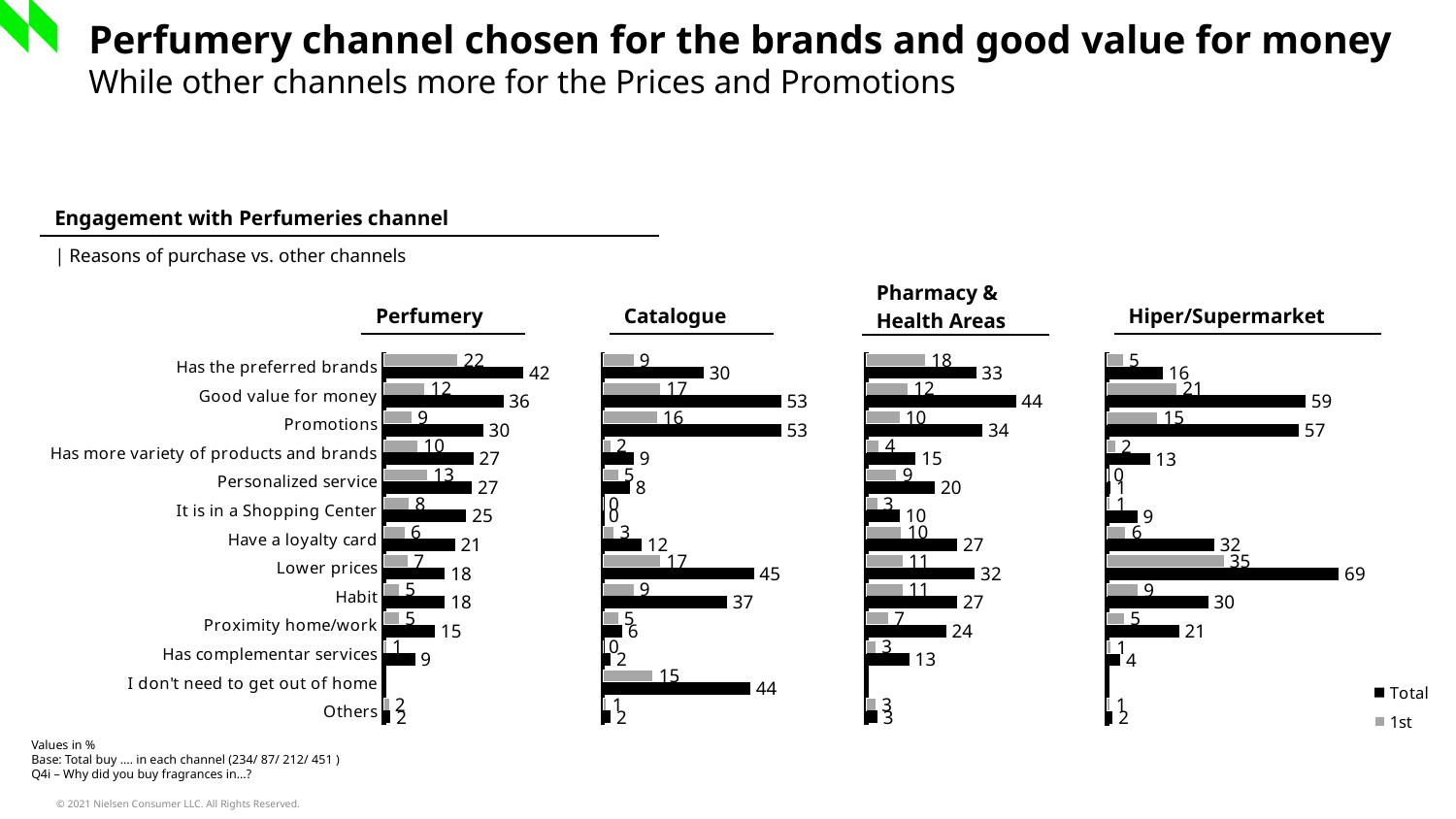
In the Perfumery chart, what is the difference between the Total values for 'Has the preferred brands' and 'Good value for money'? 6 In the Hiper/Supermarket chart, which category has the highest 1st value? Lower prices Which series is shown in black in the charts? Total In the Catalogue chart, which is larger: the Total value for 'Lower prices' or the Total value for 'Habit'? Lower prices In the Pharmacy & Health Areas chart, which category has the highest Total value? Good value for money What kind of chart is used for the Perfumery data? Bar chart In the Perfumery chart, what is the Total value for 'Has the preferred brands'? 42 In the Hiper/Supermarket chart, what is the difference between the Total and 1st values for 'Good value for money'? 38 In the Catalogue chart, what is the 1st value for 'I don't need to get out of home'? 15 How many series does the legend list? 2 In the Pharmacy & Health Areas chart, what is the 1st value for 'Has the preferred brands'? 18 In the Hiper/Supermarket chart, what is the Total value for 'Lower prices'? 69